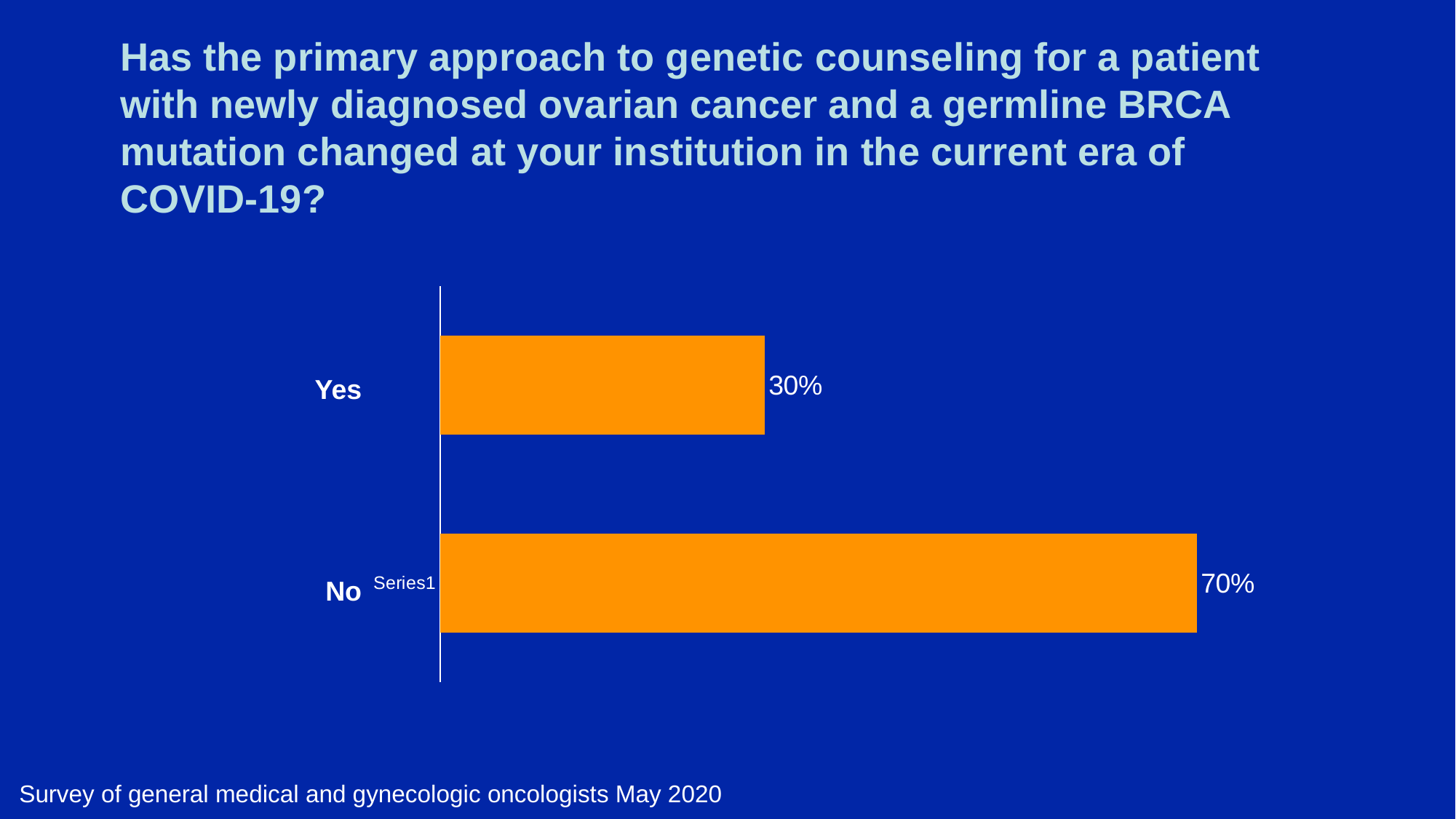
What kind of chart is shown on the slide? Bar chart Which is larger, the value for "Yes" or the value for "No"? No What colour are the bars in the chart? Orange According to the footnote, who was surveyed and when? General medical and gynecologic oncologists, May 2020 Which response category has the highest value? No What is the total of the "Yes" and "No" percentages? 100% What is the difference in percentage points between the "No" and "Yes" responses? 40% Which response category has the lowest value? Yes How many response categories are shown in the chart? 2 What percentage of respondents answered "No"? 70% What percentage of respondents answered "Yes"? 30%